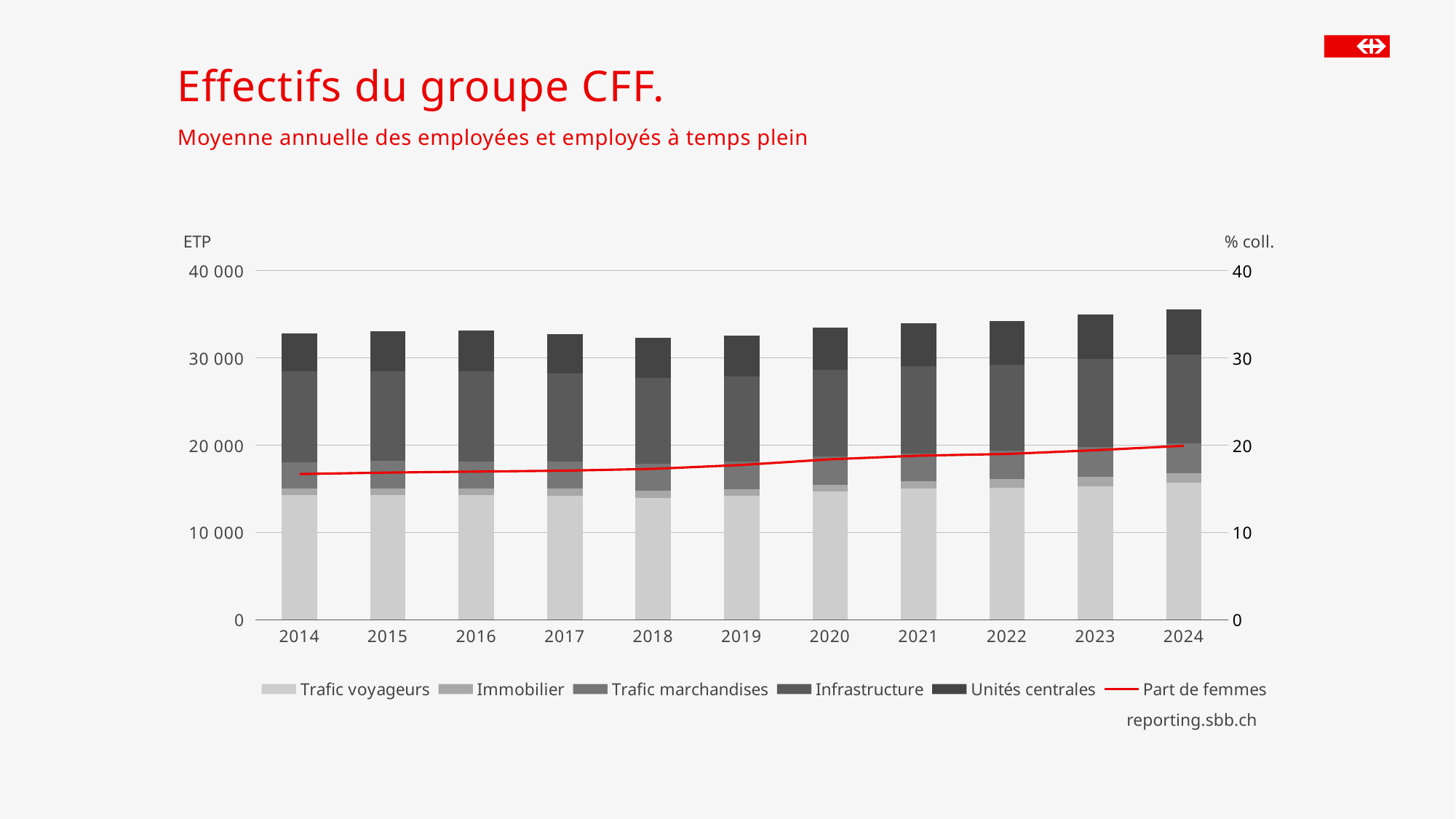
What is the title of the chart on the slide? Effectifs du groupe CFF. Which is larger, the total ETP for 2014 or for 2024? 2024 Does the Part de femmes line rise or fall from 2014 to 2024? rise How many series does the legend list? 6 Which year has the highest total number of ETP? 2024 Is the total ETP for 2024 greater or less than 30 000? greater How many years are shown on the x axis of the chart? 11 Is the Part de femmes value for 2014 greater or less than 20? less What is the label of the right-hand axis? % coll. What kind of chart is shown on the slide? Stacked bar chart with a line Is the total ETP for 2014 greater or less than 40 000? less